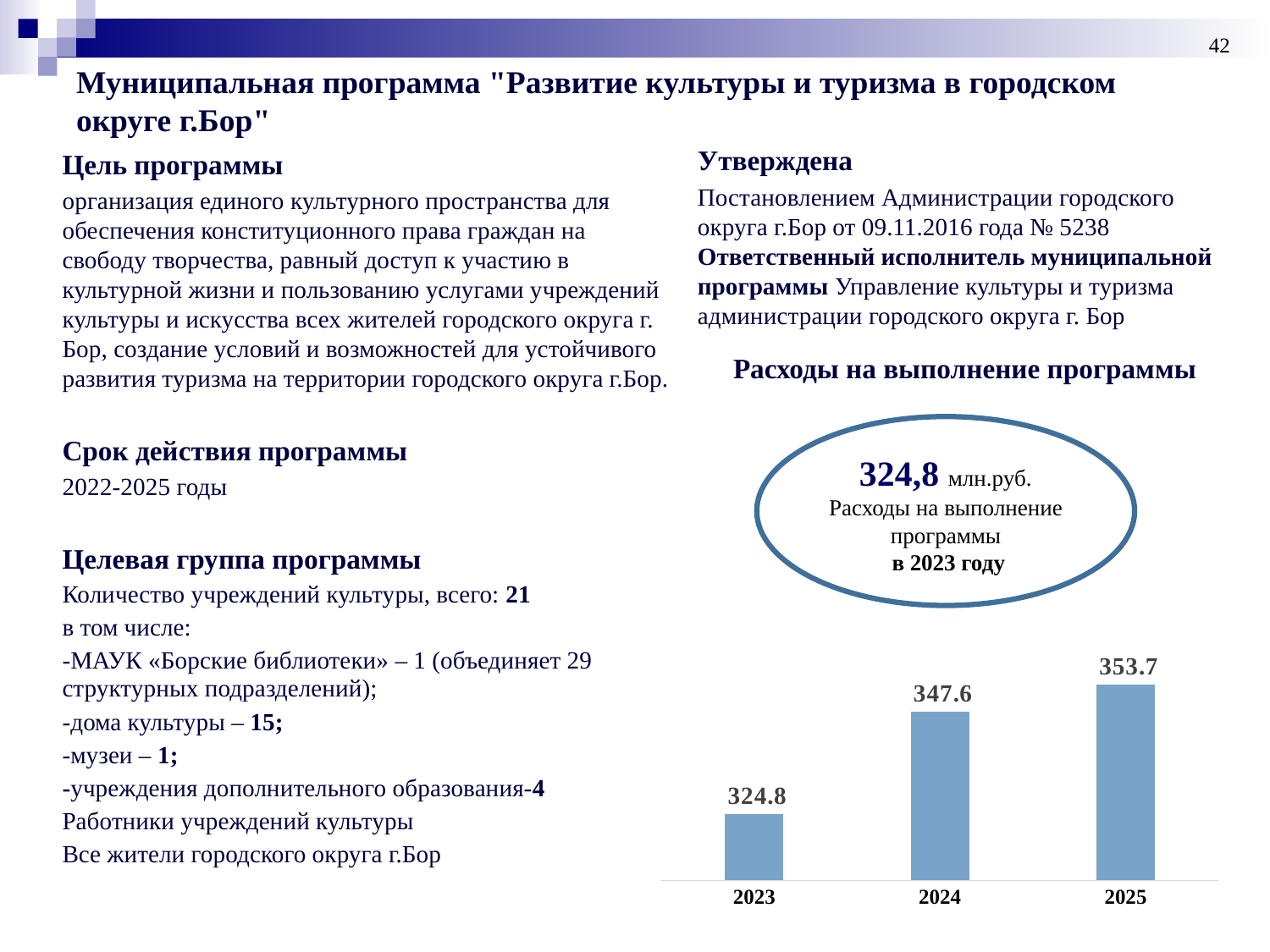
What kind of chart is shown on the slide? Bar chart What is the title of the chart on the slide? Расходы на выполнение программы What is the value for 2024 in the chart? 347.6 Which year has the lowest value in the chart? 2023 How many bars are shown in the chart? 3 What is the value for 2023 in the chart? 324.8 What is the difference between the values for 2025 and 2023? 28.9 Do the values rise or fall from 2023 to 2025? Rise Which is larger, the value for 2024 or the value for 2023? 2024 Which year has the highest value in the chart? 2025 What is the difference between the values for 2024 and 2023? 22.8 What is the value for 2025 in the chart? 353.7